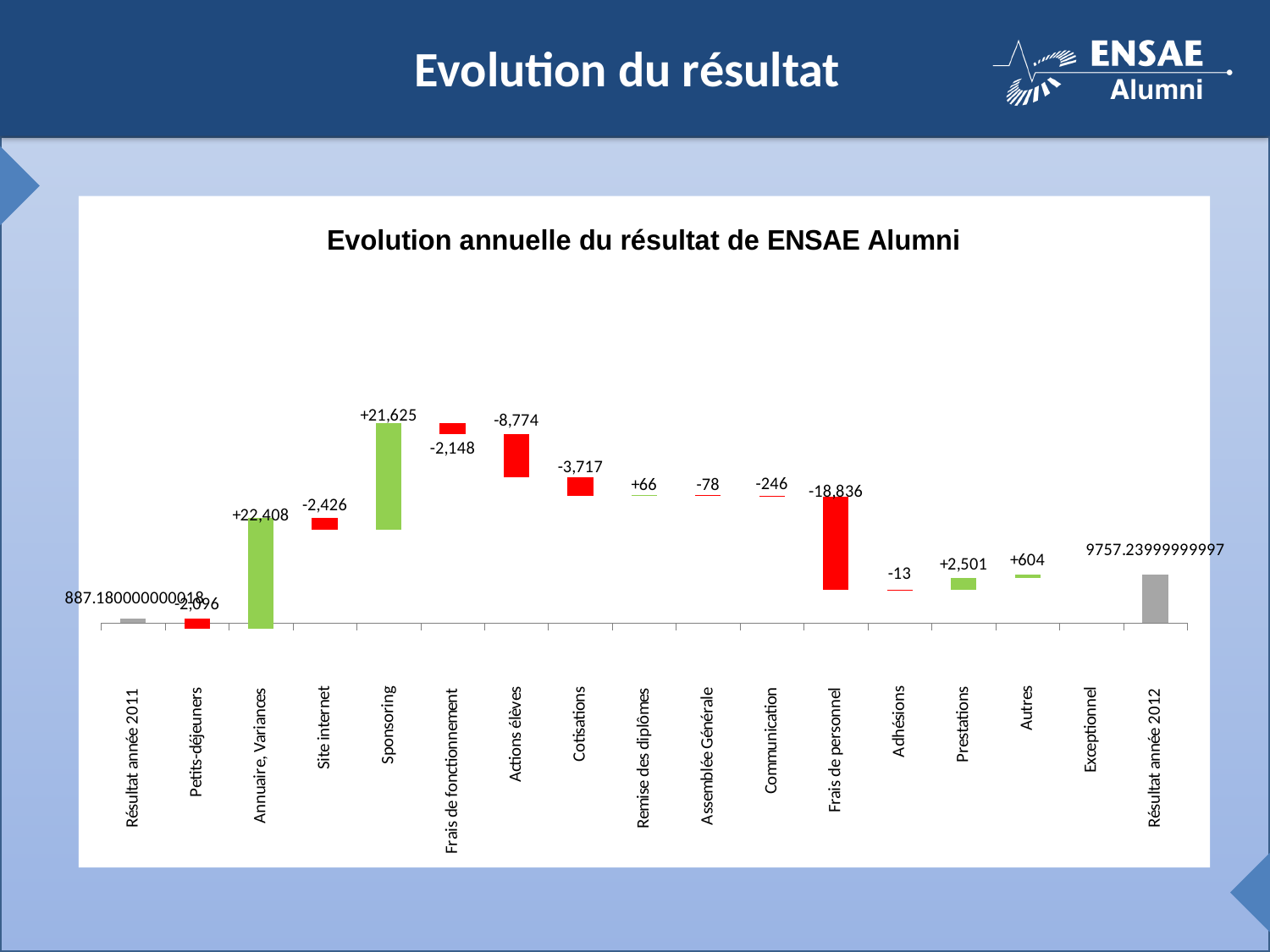
Which is larger in absolute value, the change for Cotisations or the change for Site internet? Cotisations How many categories are shown on the x axis? 17 What is the value shown for Frais de personnel? -18,836 What is the title of the chart? Evolution annuelle du résultat de ENSAE Alumni Which category shows the largest positive change? Annuaire, Variances What is the difference between the change for Annuaire, Variances and the change for Sponsoring? 783 What is the value shown for Sponsoring? +21,625 What is the value shown for Actions élèves? -8,774 What is the value shown for Résultat année 2012? 9757.23999999997 What type of chart is shown on the slide? bar chart Which category shows the largest negative change? Frais de personnel What is the value shown for Prestations? +2,501